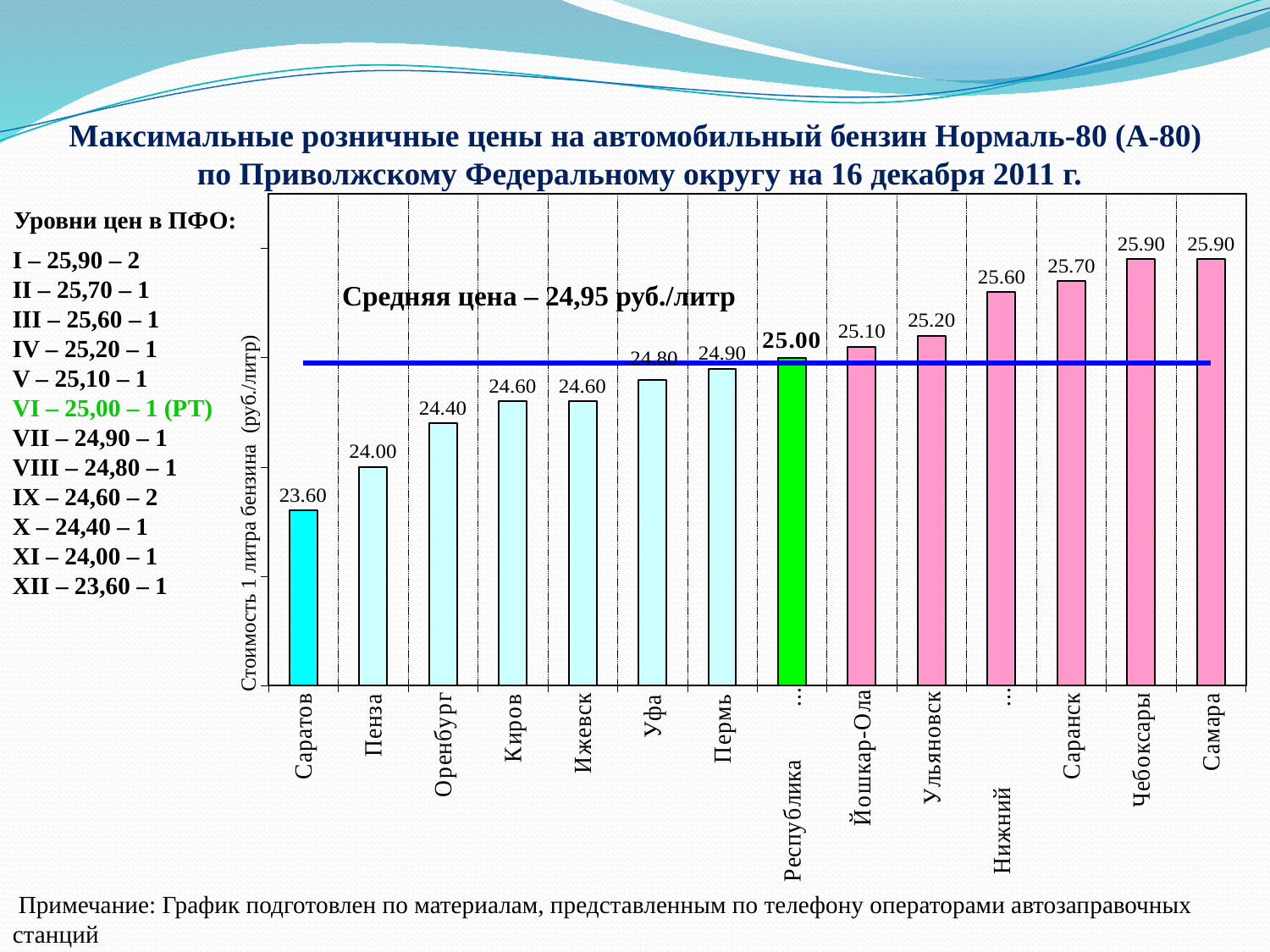
What is the value for Саранск? 25.70 How many bars are plotted in the chart? 14 What is the difference between the values for Йошкар-Ола and Оренбург? 0.70 Which category has the lowest value? Саратов What is the value for Саратов? 23.60 Which is larger, the value for Уфа or the value for Пенза? Уфа What is the difference between the values for Самара and Саратов? 2.30 What is the value for Ульяновск? 25.20 Do the values rise or fall from left to right along the x axis? rise What average price is stated on the chart? 24,95 руб./литр What kind of chart is shown on the slide? bar chart What is the value for Пермь? 24.90